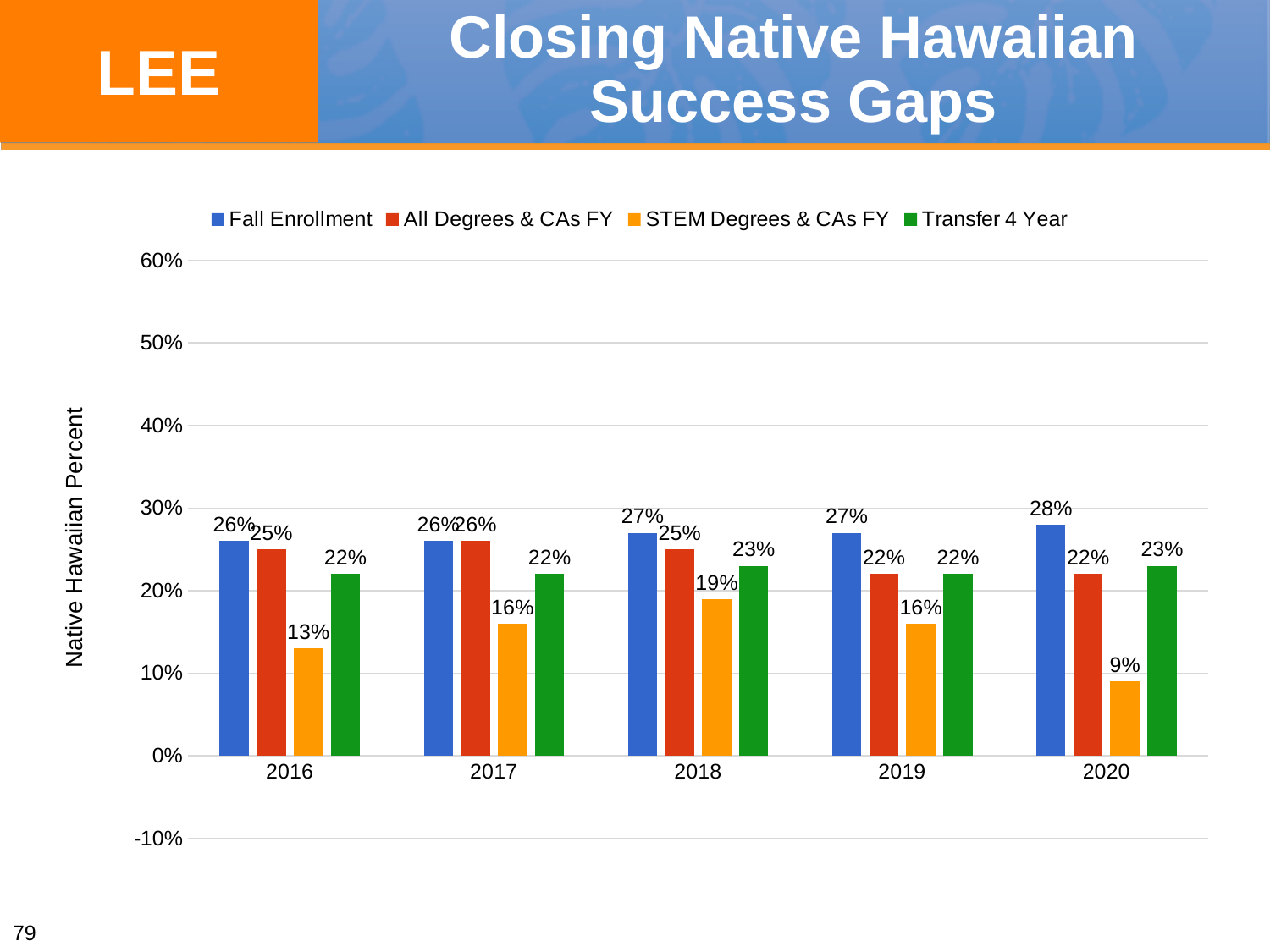
What is the difference between the Fall Enrollment and STEM Degrees & CAs FY values in 2020? 19% Which is larger in 2016: the STEM Degrees & CAs FY value or the Transfer 4 Year value? Transfer 4 Year What is the label on the vertical axis? Native Hawaiian Percent What is the Transfer 4 Year value for 2016? 22% What kind of chart is shown on the slide? Bar chart How many series does the legend list? 4 In which year is the Fall Enrollment value highest? 2020 What is the STEM Degrees & CAs FY value for 2018? 19% What is the All Degrees & CAs FY value for 2019? 22% How many years are shown on the x axis? 5 In which year is the STEM Degrees & CAs FY value lowest? 2020 What is the Fall Enrollment value for 2020? 28%